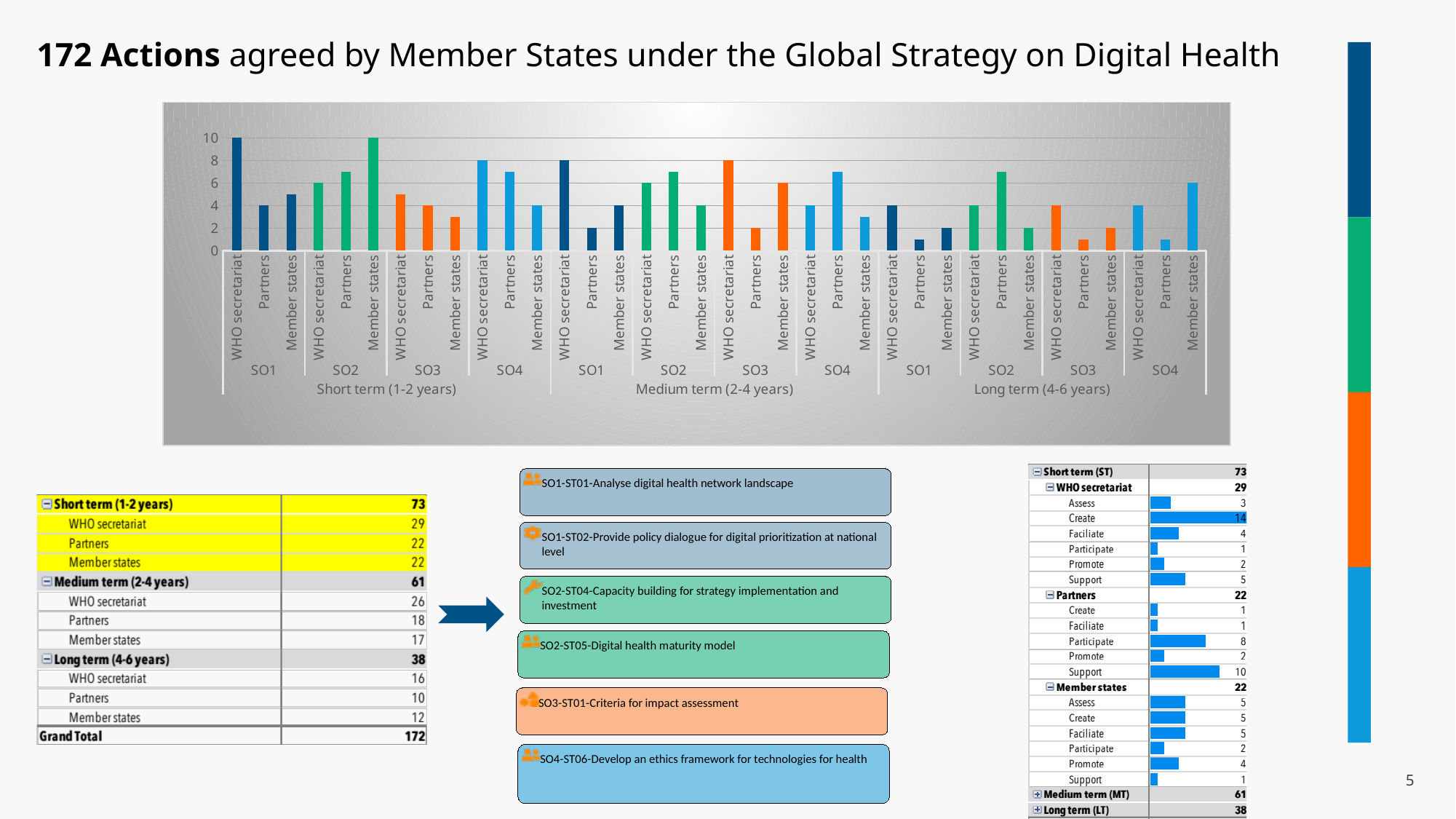
In the top bar chart, which is larger in the Short term (1-2 years) SO1 group: WHO secretariat or Partners? WHO secretariat In the bar table at the bottom right of the slide, what is the value for Create under WHO secretariat? 14 In the top bar chart, is the value for Member states under SO2 in the Short term (1-2 years) group greater or less than 8? greater In the top bar chart, how many time-horizon groups are shown along the x axis? 3 In the bar table at the bottom right of the slide, which action under Partners has the highest value? Support In the top bar chart, what is the highest value shown on the vertical axis? 10 In the top bar chart, is the value for Partners under SO2 in the Long term (4-6 years) group greater or less than 6? greater In the top bar chart, which is larger in the Medium term (2-4 years) SO3 group: WHO secretariat or Partners? WHO secretariat What kind of chart is the large chart at the top of the slide? bar chart In the top bar chart, is the value for WHO secretariat under SO1 in the Short term (1-2 years) group greater or less than 8? greater In the top bar chart, what are the three time-horizon groups labelled along the x axis? Short term (1-2 years), Medium term (2-4 years), Long term (4-6 years)